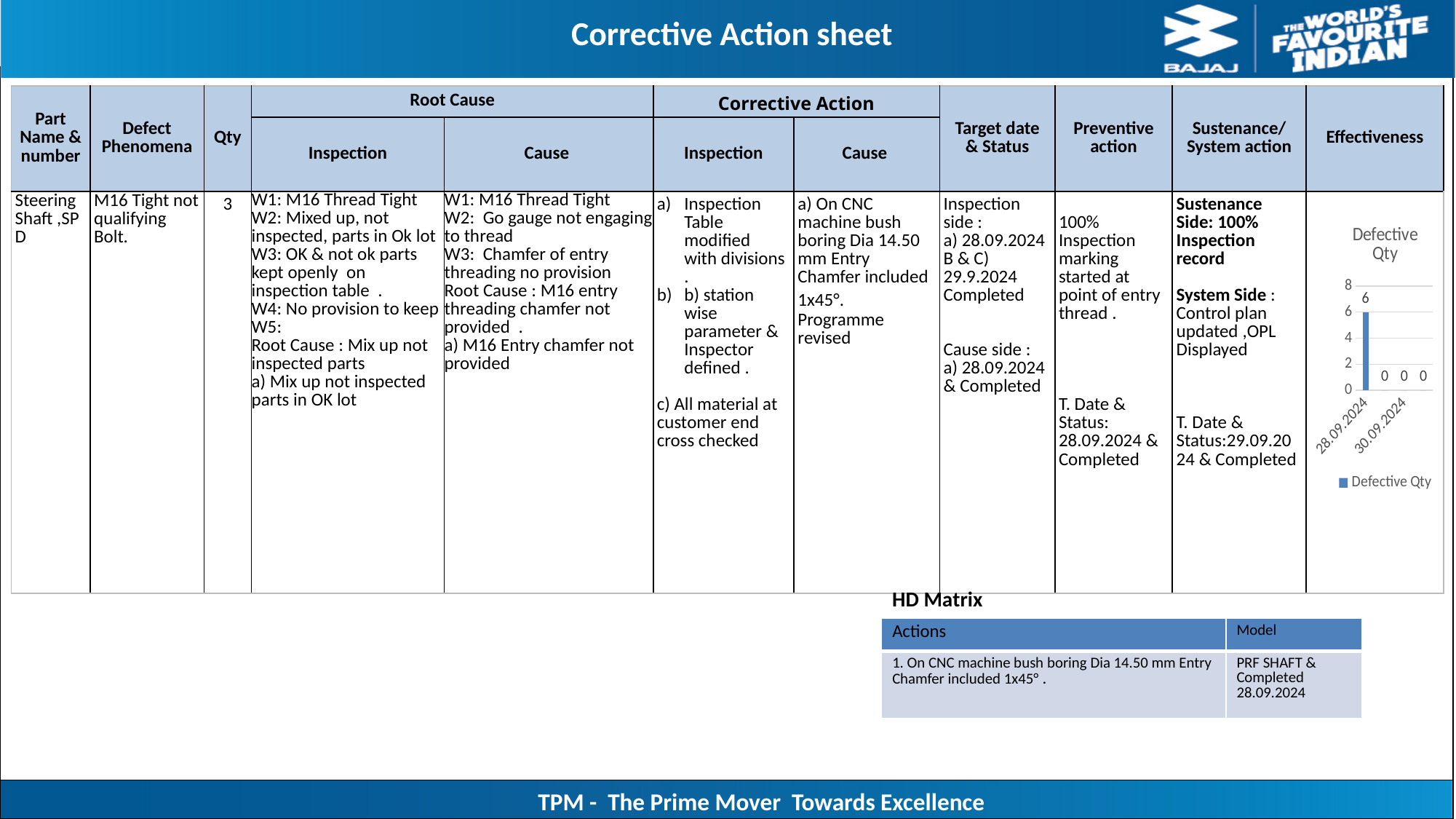
What is the difference between the Defective Qty for 28.09.2024 and 30.09.2024? 6 Is the Defective Qty for 28.09.2024 greater or less than 4? greater How many series does the legend of the Defective Qty chart list? 1 What is the legend entry of the Defective Qty chart? Defective Qty Which is larger, the Defective Qty for 28.09.2024 or for 30.09.2024? 28.09.2024 Do the Defective Qty values rise or fall along the x axis? fall Is the Defective Qty for 28.09.2024 greater or less than 8? less What is the title of the chart in the Effectiveness column? Defective Qty What kind of chart is shown in the Effectiveness column? bar chart What is the Defective Qty value for 30.09.2024? 0 What is the Defective Qty value for 28.09.2024? 6 Which date has the highest Defective Qty? 28.09.2024